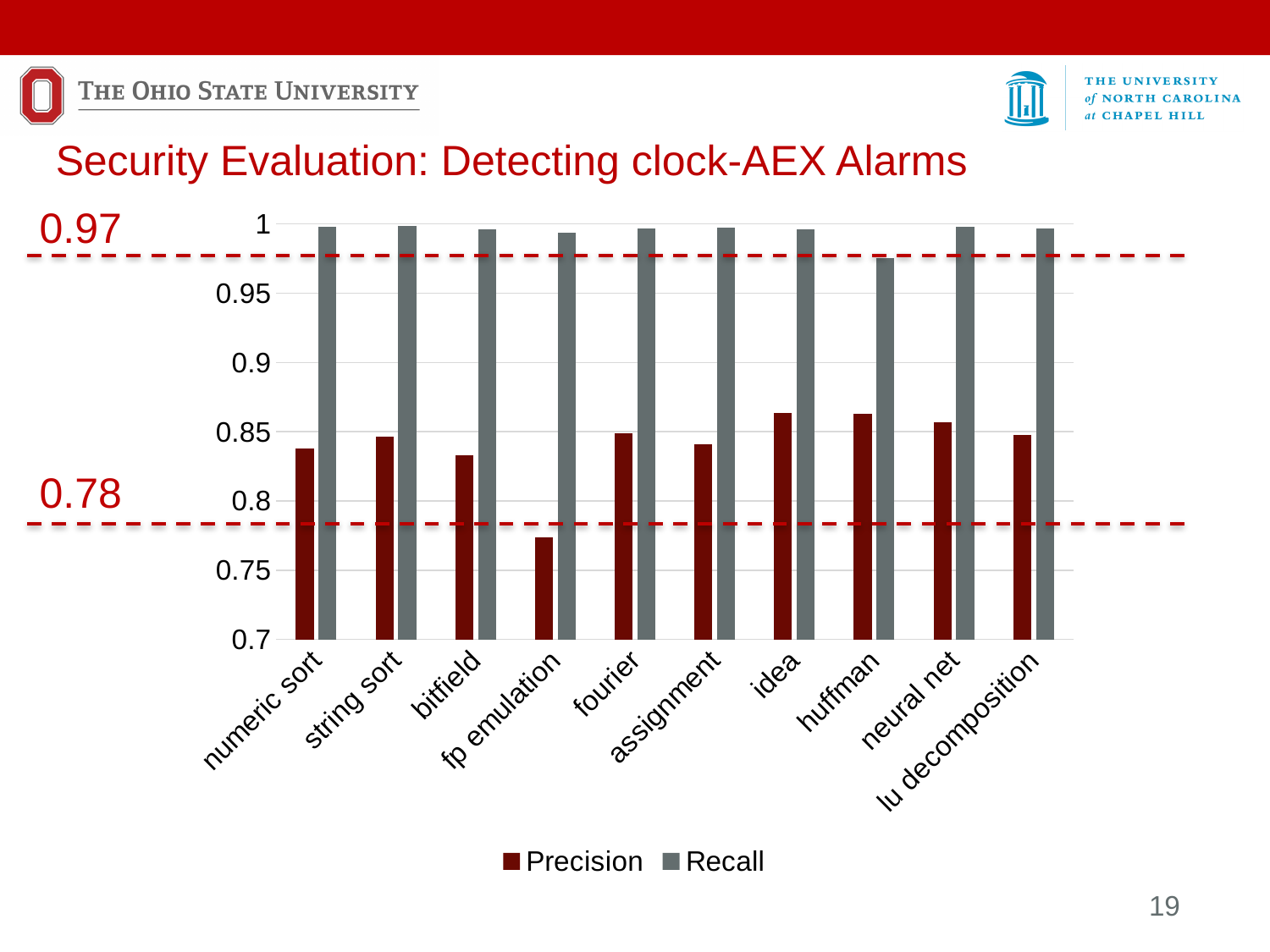
Which benchmark has the lowest Precision? fp emulation Is the Recall value for huffman greater or less than 0.95? greater Is the Precision value for idea greater or less than 0.85? greater Is the Precision value for fp emulation greater or less than 0.8? less What is the title of the chart on the slide? Security Evaluation: Detecting clock-AEX Alarms How many series does the legend list? 2 How many benchmark categories are shown on the x axis? 10 Which is larger, the Precision for fp emulation or the Precision for idea? idea What kind of chart is shown on the slide? bar chart For numeric sort, which is larger, Precision or Recall? Recall Which benchmark has the lowest Recall? huffman